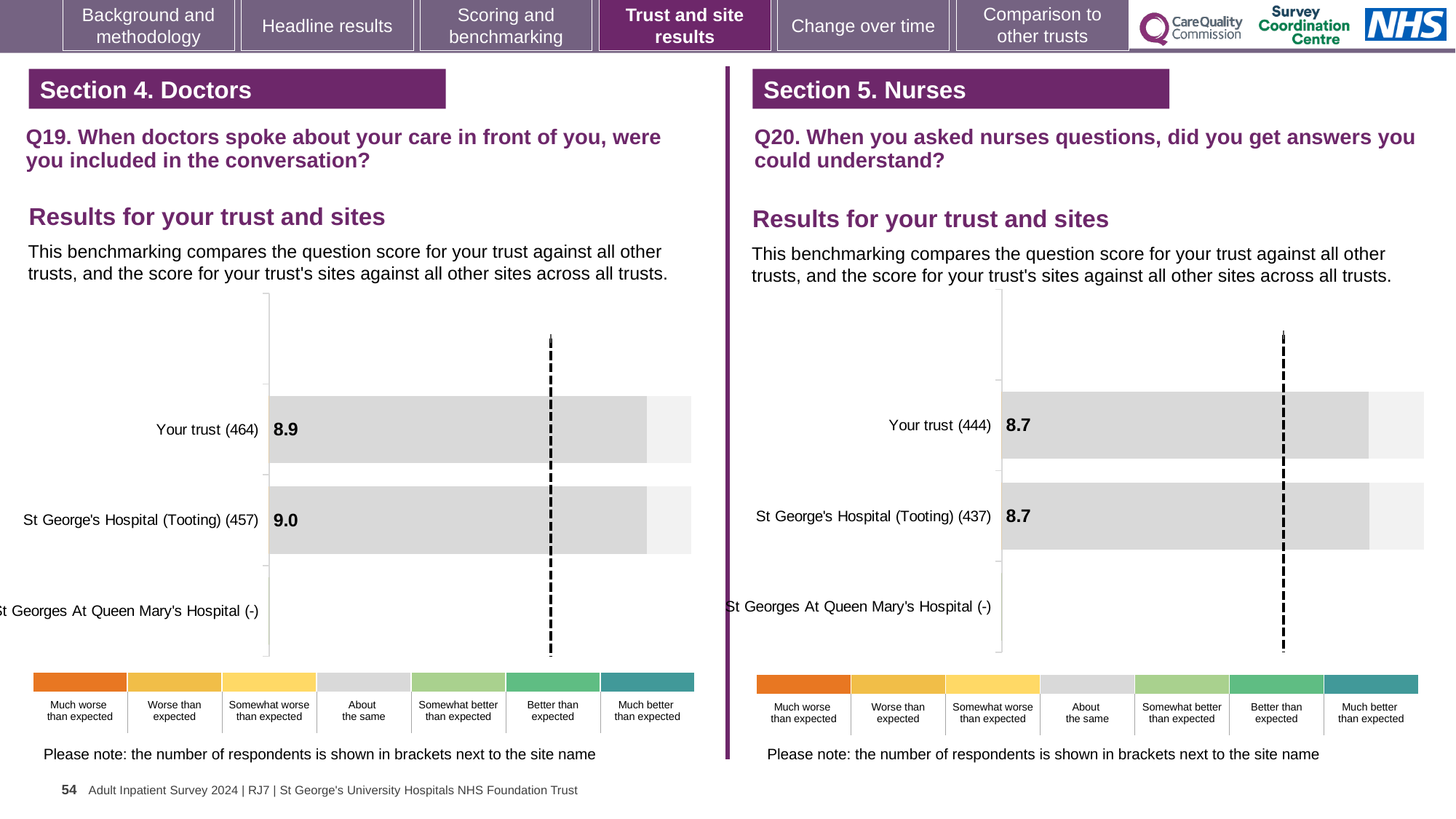
How many categories are listed on the vertical axis of the Q19 chart on the left? 3 In the Q19 chart on the left, what is the difference between the score for St George's Hospital (Tooting) and the score for Your trust? 0.1 In the Q19 chart on the left, what is the score for St George's Hospital (Tooting)? 9.0 In the Q19 chart on the left, what is the score for Your trust? 8.9 In the Q20 chart on the right, what is the score for Your trust? 8.7 In the Q20 chart on the right, what is the score for St George's Hospital (Tooting)? 8.7 In the Q20 chart on the right, what is the difference between the score for Your trust and the score for St George's Hospital (Tooting)? 0 What type of chart is used for the Q19 results on the left? Bar chart How many categories are listed on the vertical axis of the Q20 chart on the right? 3 In the Q20 chart on the right, how many respondents are shown in brackets for St George's Hospital (Tooting)? 437 In the Q19 chart on the left, how many respondents are shown in brackets for Your trust? 464 In the Q19 chart on the left, which has the higher score: Your trust or St George's Hospital (Tooting)? St George's Hospital (Tooting)